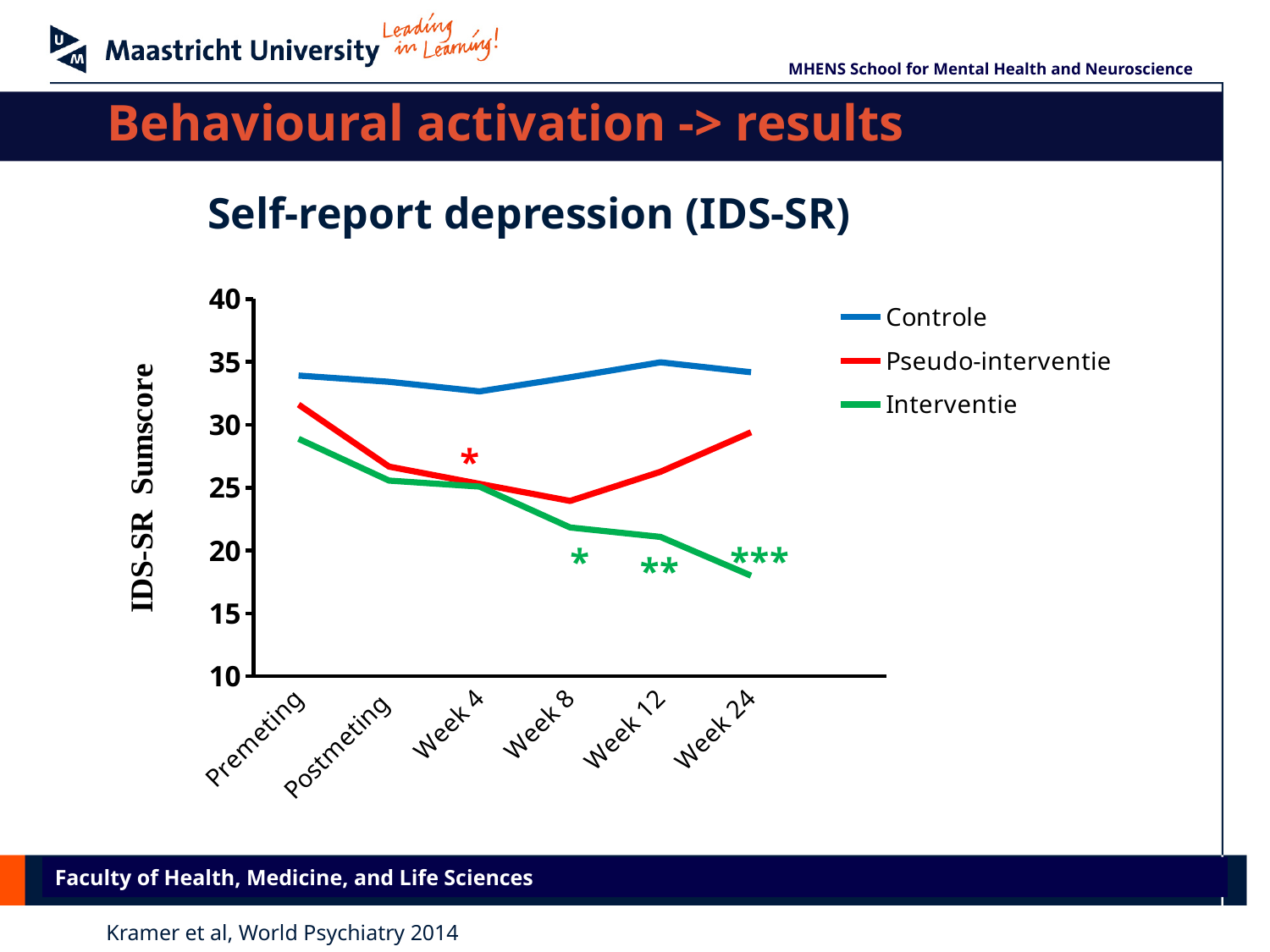
Is the value for Pseudo-interventie at Week 8 greater or less than 30? less At Week 12, which series has the larger value, Pseudo-interventie or Interventie? Pseudo-interventie What kind of chart is shown on the slide? line chart Is the value for Interventie at Premeting greater or less than 25? greater Is the value for Interventie at Week 24 greater or less than 20? less Does the Interventie line rise or fall from Premeting to Week 24? fall What is the label on the y axis? IDS-SR Sumscore How many time points are shown on the x axis? 6 How many series does the legend list? 3 Which series has the lowest value at Week 24? Interventie At Week 24, which series has the larger value, Controle or Interventie? Controle